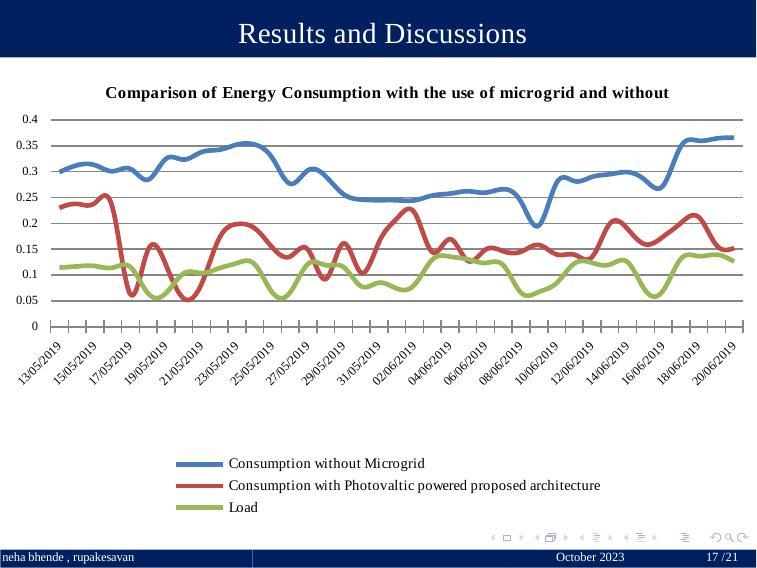
Is the value for Consumption with Photovaltic powered proposed architecture on 02/06/2019 greater or less than 0.2? greater How many date labels are shown on the x axis? 20 Is the value for Consumption without Microgrid on 18/06/2019 greater or less than 0.3? greater Does the Consumption without Microgrid line rise or fall between 23/05/2019 and 31/05/2019? fall Is the value for Consumption without Microgrid on 20/06/2019 greater or less than 0.35? greater Which series is drawn in green? Load What is the title of the chart? Comparison of Energy Consumption with the use of microgrid and without How many series does the legend list? 3 On 13/05/2019, which is larger: Consumption without Microgrid or Consumption with Photovaltic powered proposed architecture? Consumption without Microgrid What kind of chart is shown on the slide? line chart